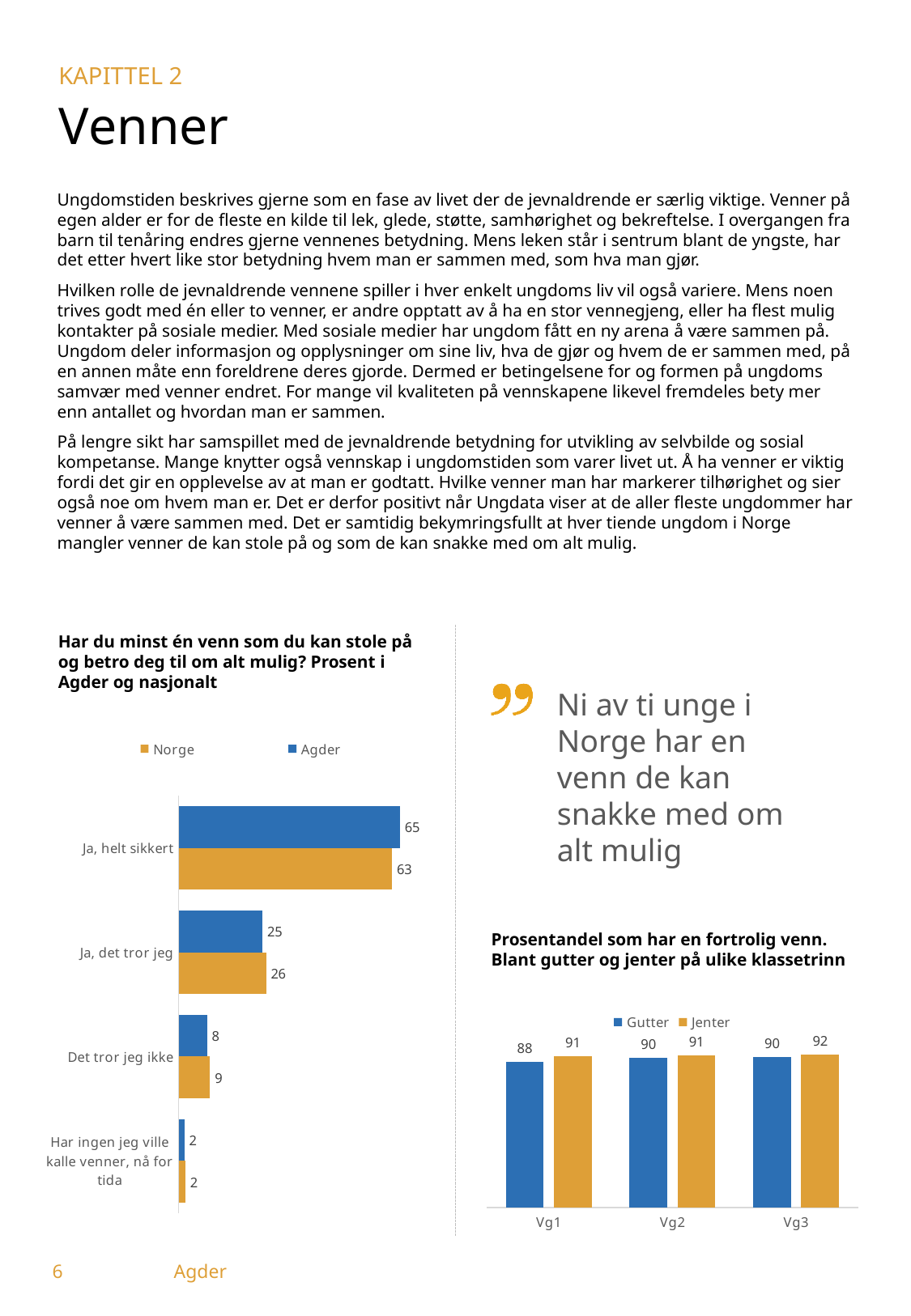
In the chart 'Prosentandel som har en fortrolig venn', what is the difference between Jenter and Gutter at Vg1? 3 In the chart 'Har du minst én venn som du kan stole på og betro deg til om alt mulig?', what is the difference between Agder and Norge for 'Ja, helt sikkert'? 2 In the chart 'Har du minst én venn som du kan stole på og betro deg til om alt mulig?', which category has the highest value for Agder? Ja, helt sikkert In the chart 'Har du minst én venn som du kan stole på og betro deg til om alt mulig?', what is the value for Norge for 'Ja, det tror jeg'? 26 In the chart 'Har du minst én venn som du kan stole på og betro deg til om alt mulig?', how many categories are shown? 4 In the chart 'Prosentandel som har en fortrolig venn', which colour represents Jenter? Orange In the chart 'Prosentandel som har en fortrolig venn', what is the value for Jenter at Vg3? 92 In the chart 'Har du minst én venn som du kan stole på og betro deg til om alt mulig?', how many series does the legend list? 2 What kind of chart is 'Har du minst én venn som du kan stole på og betro deg til om alt mulig?'? Bar chart In the chart 'Prosentandel som har en fortrolig venn', which series has the higher value at Vg2, Gutter or Jenter? Jenter In the chart 'Prosentandel som har en fortrolig venn', what is the value for Gutter at Vg1? 88 In the chart 'Har du minst én venn som du kan stole på og betro deg til om alt mulig?', what is the value for Agder for 'Ja, helt sikkert'? 65